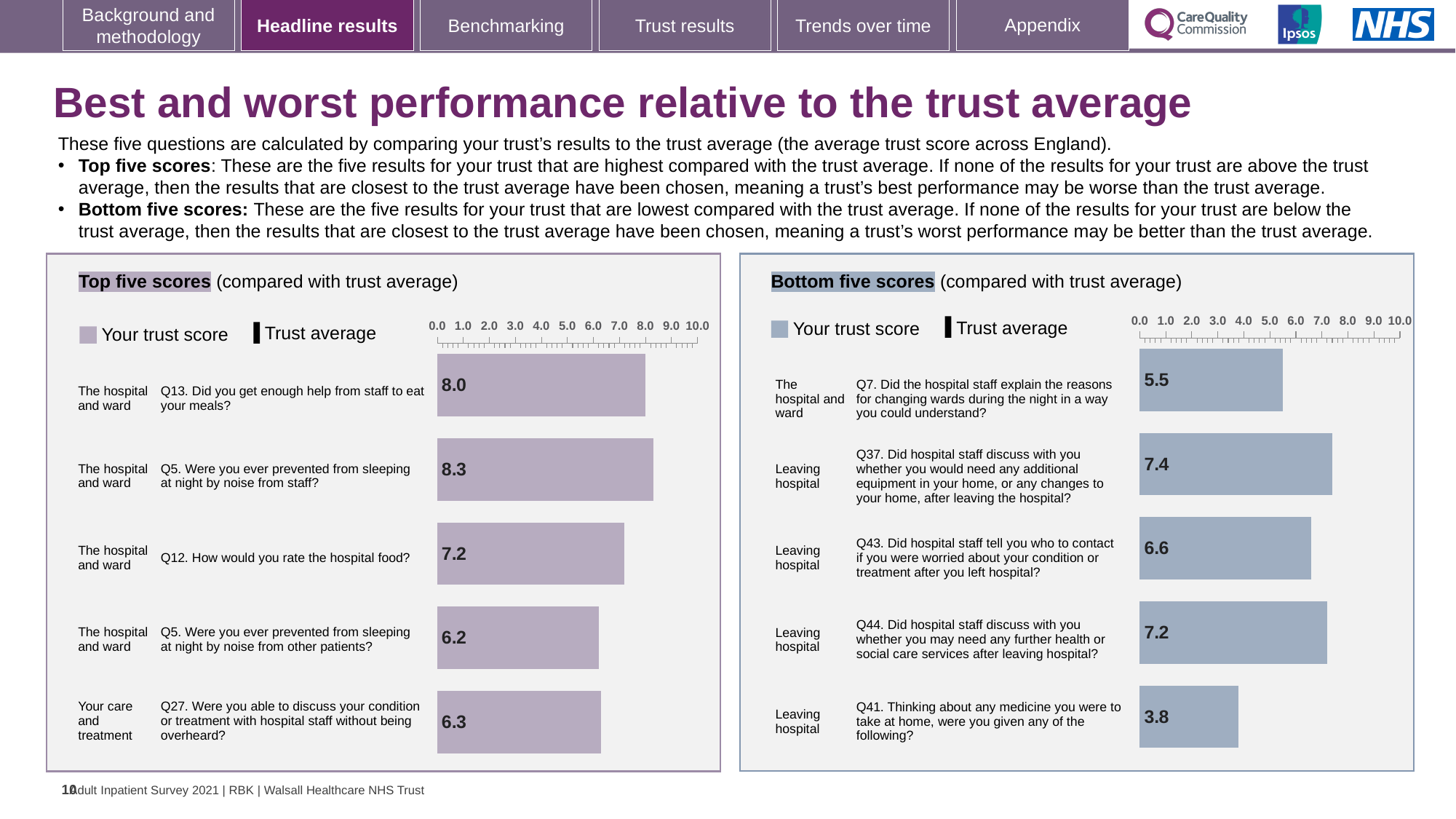
In the Bottom five scores chart, what is the trust score for Q41 (Thinking about any medicine you were to take at home, were you given any of the following?)? 3.8 In the Top five scores chart, which question has the highest trust score? Q5. Were you ever prevented from sleeping at night by noise from staff? In the Bottom five scores chart, what is the difference between the score for Q37 and the score for Q41? 3.6 In the Top five scores chart, what is the difference between the score for Q5 (noise from staff) and the score for Q5 (noise from other patients)? 2.1 What kind of chart is the Bottom five scores chart? Bar chart In the Top five scores chart, what is the trust score for Q13 (Did you get enough help from staff to eat your meals?)? 8.0 In the Top five scores chart, what is the trust score for Q12 (How would you rate the hospital food?)? 7.2 In the Bottom five scores chart, which question has the lowest trust score? Q41. Thinking about any medicine you were to take at home, were you given any of the following? In the Bottom five scores chart, which question has the highest trust score? Q37. Did hospital staff discuss with you whether you would need any additional equipment in your home, or any changes to your home, after leaving the hospital? In the Bottom five scores chart, what is the trust score for Q43 (Did hospital staff tell you who to contact if you were worried about your condition or treatment after you left hospital?)? 6.6 In the Bottom five scores chart, which has the larger score: Q7 or Q44? Q44 How many questions are shown in the Top five scores chart? 5